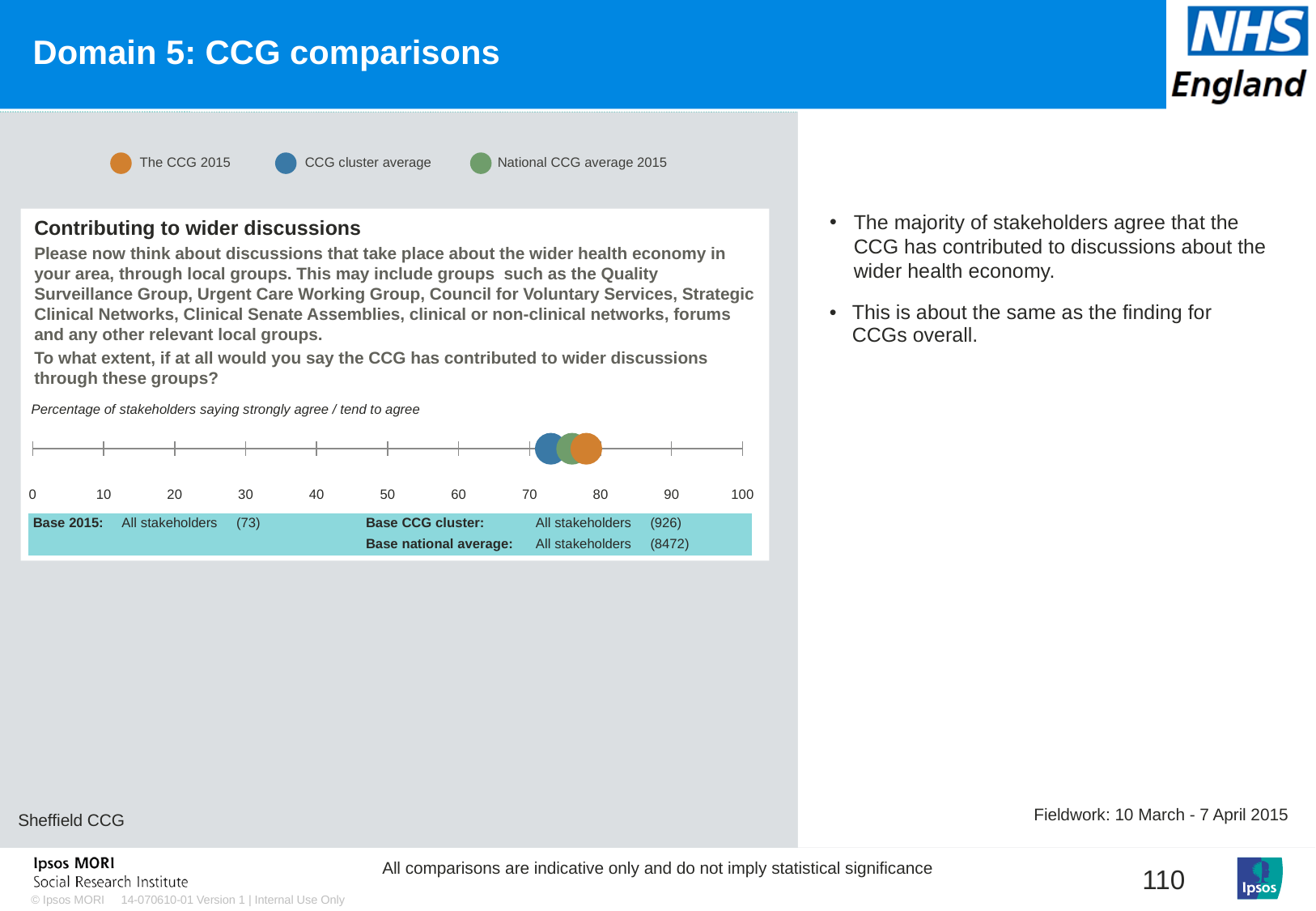
What kind of chart is shown? Dot plot What is the maximum value shown on the axis? 100 Is the value for CCG cluster average greater or less than 80? less Is the value for The CCG 2015 greater or less than 70? greater How many series does the legend list? 3 Is the value for National CCG average 2015 greater or less than 80? less Which is larger, the value for The CCG 2015 or the value for CCG cluster average? The CCG 2015 How many data points are plotted on the axis? 3 What colour marks The CCG 2015 in the legend? Orange